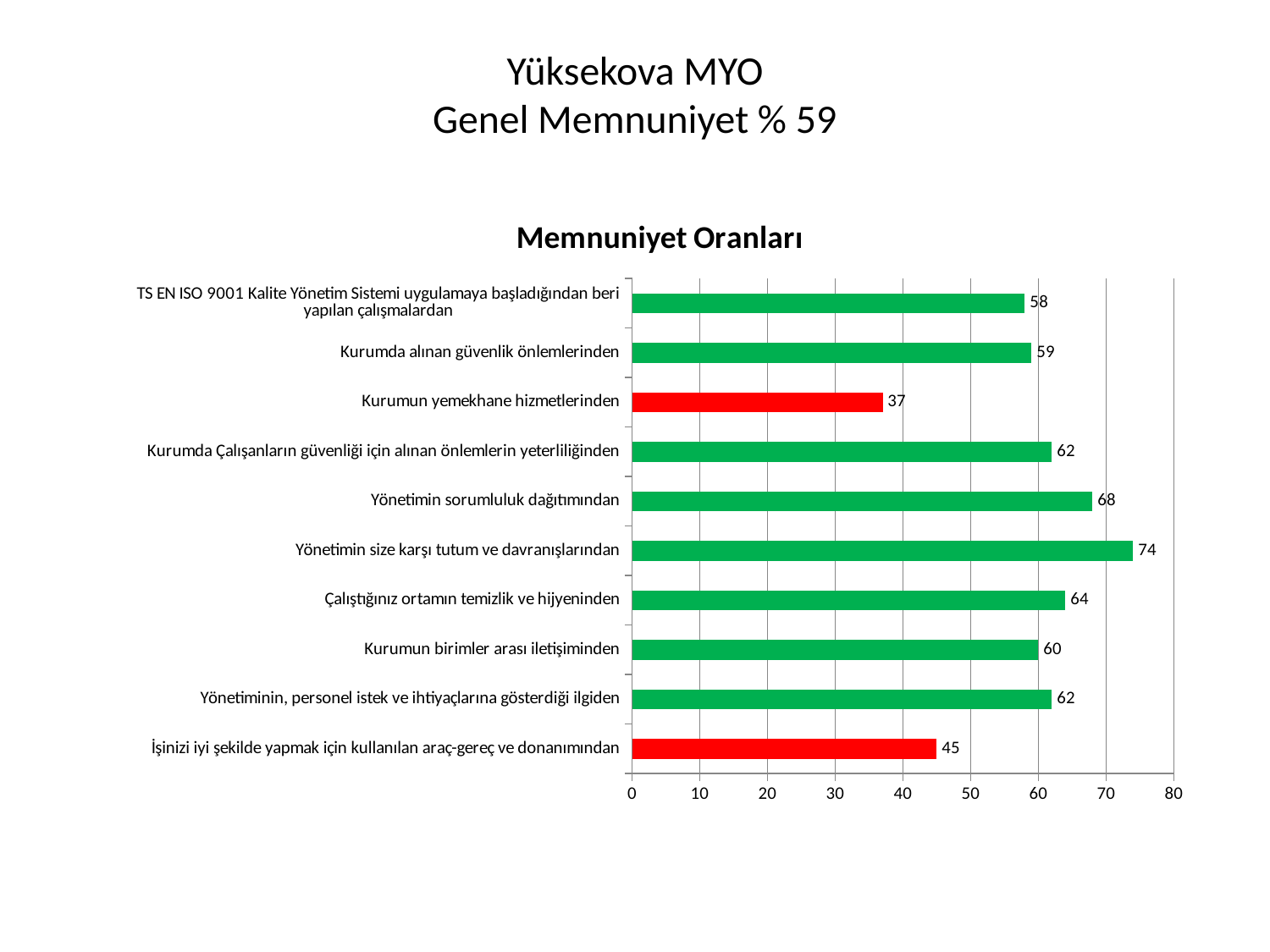
How many categories are shown in the chart? 10 Which category has the lowest value? Kurumun yemekhane hizmetlerinden What kind of chart is shown on the slide? bar chart Which is larger: the value for "Çalıştığınız ortamın temizlik ve hijyeninden" or the value for "Kurumda alınan güvenlik önlemlerinden"? Çalıştığınız ortamın temizlik ve hijyeninden Which category has the highest value? Yönetimin size karşı tutum ve davranışlarından What is the value for "Kurumun yemekhane hizmetlerinden"? 37 What is the title of the chart? Memnuniyet Oranları What is the value for "Kurumun birimler arası iletişiminden"? 60 What is the difference between the values for "Yönetimin size karşı tutum ve davranışlarından" and "Kurumun yemekhane hizmetlerinden"? 37 Is the value for "İşinizi iyi şekilde yapmak için kullanılan araç-gereç ve donanımından" greater or less than 50? less What is the value for "Yönetimin sorumluluk dağıtımından"? 68 How many bars are coloured red? 2